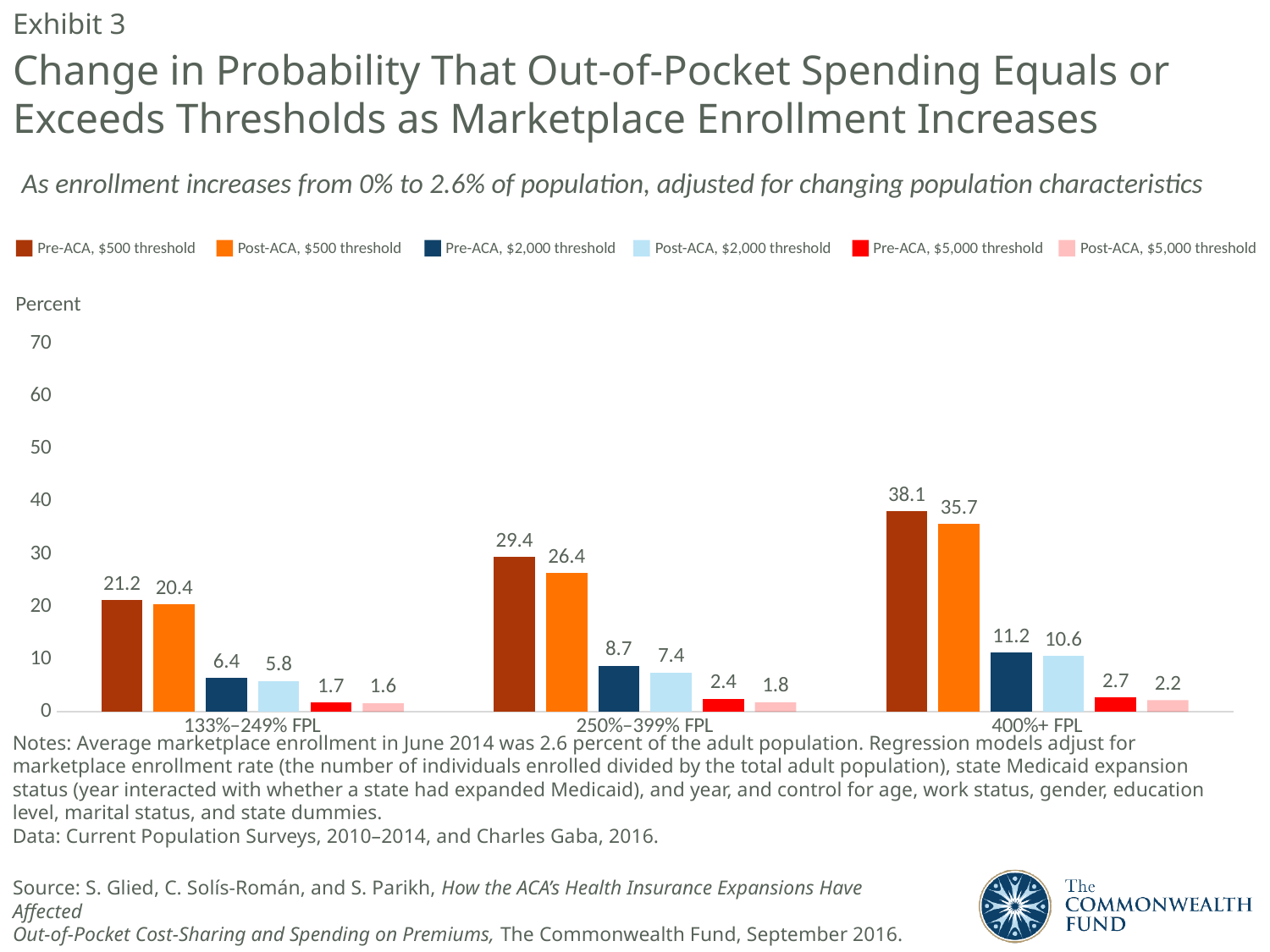
Which income group has the highest value for Pre-ACA, $500 threshold? 400%+ FPL Is the value for Post-ACA, $500 threshold in the 400%+ FPL group greater or less than 30? greater What kind of chart is shown on the slide? Bar chart How many series does the legend list? 6 Which income group has the lowest value for Pre-ACA, $2,000 threshold? 133%–249% FPL Which is larger in the 400%+ FPL group: Pre-ACA, $2,000 threshold or Post-ACA, $2,000 threshold? Pre-ACA, $2,000 threshold What is the value for Post-ACA, $5,000 threshold in the 133%–249% FPL group? 1.6 How many income groups are shown on the x axis? 3 What is the difference between the Pre-ACA, $500 threshold and Post-ACA, $500 threshold values in the 250%–399% FPL group? 3.0 What is the value for Post-ACA, $2,000 threshold in the 250%–399% FPL group? 7.4 What is the value for Pre-ACA, $500 threshold in the 400%+ FPL group? 38.1 Do the Post-ACA, $500 threshold values rise or fall as income group increases along the x axis? Rise